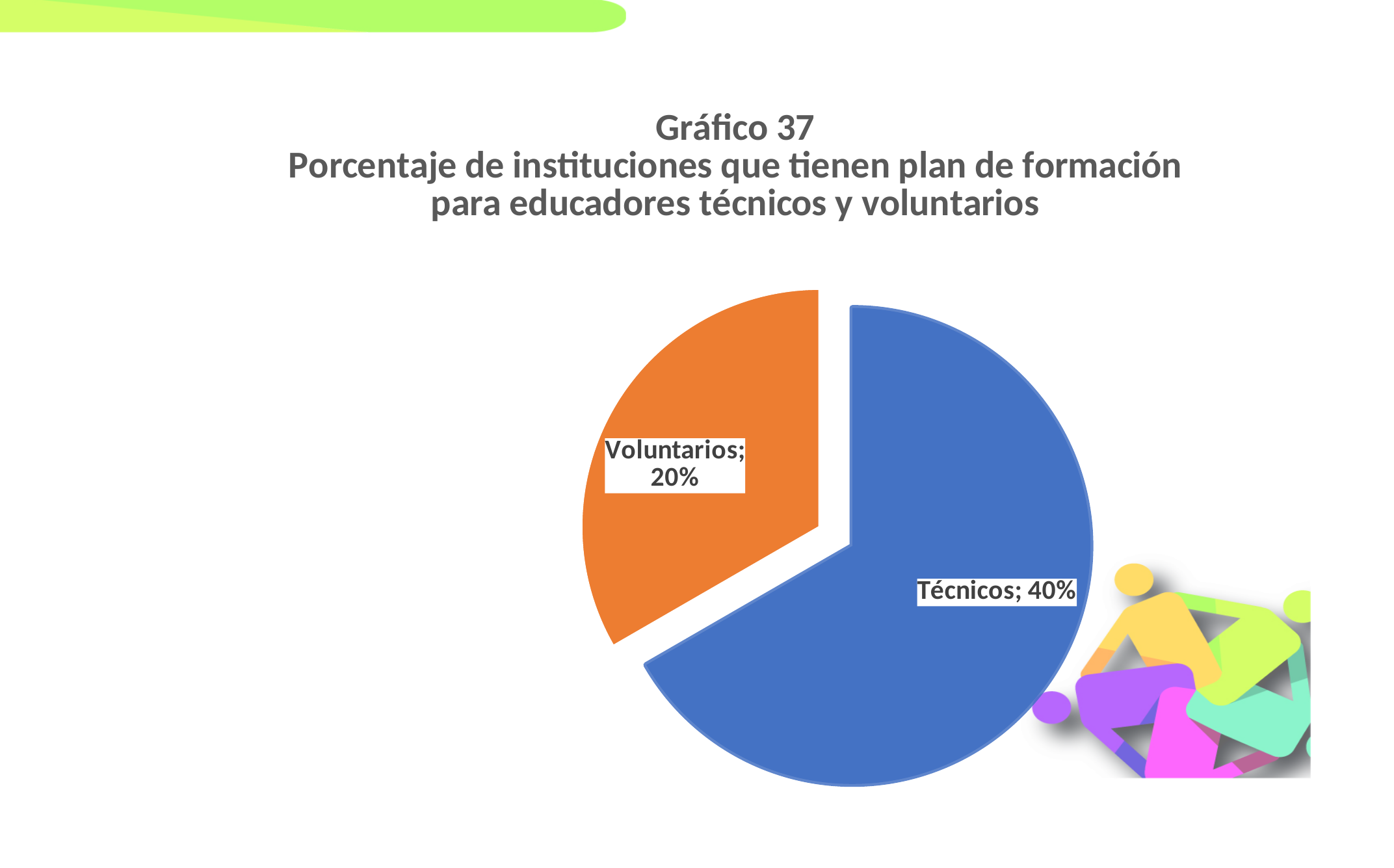
What colour is the Voluntarios slice in the pie chart? Orange Which category has the smallest slice in the pie chart? Voluntarios What value is shown for Técnicos in the pie chart? 40% Which is larger, the value for Técnicos or the value for Voluntarios? Técnicos Which category has the largest slice in the pie chart? Técnicos How many categories are shown in the pie chart? 2 What is the number of the chart given in its title? Gráfico 37 What kind of chart is shown on the slide? Pie chart What value is shown for Voluntarios in the pie chart? 20% What is the difference between the values for Técnicos and Voluntarios? 20%